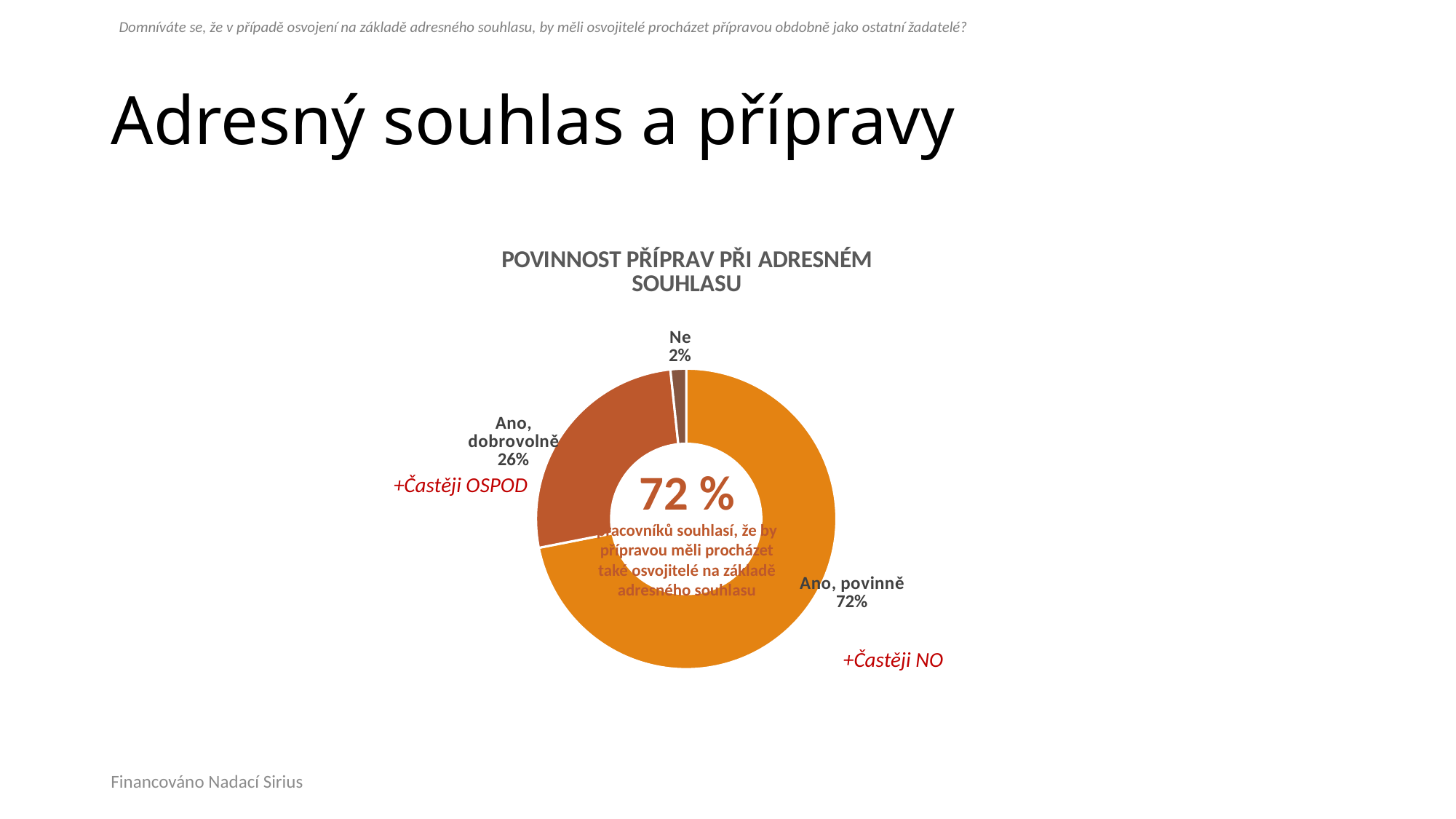
What share of the pie does the "Ano, povinně" slice represent? 72% What large percentage is printed in the centre of the doughnut chart? 72 % How many categories are shown in the chart? 3 What is the value shown for the "Ne" slice? 2% What is the difference in percentage points between "Ano, povinně" and "Ano, dobrovolně"? 46 What kind of chart is shown on the slide? Pie chart (doughnut) What share of the pie does the "Ano, dobrovolně" slice represent? 26% Which category has the smallest slice of the pie? Ne Which is larger, the "Ano, dobrovolně" slice or the "Ne" slice? Ano, dobrovolně What is the difference in percentage points between "Ano, dobrovolně" and "Ne"? 24 What is the title of the chart? POVINNOST PŘÍPRAV PŘI ADRESNÉM SOUHLASU Which category has the largest slice of the pie? Ano, povinně